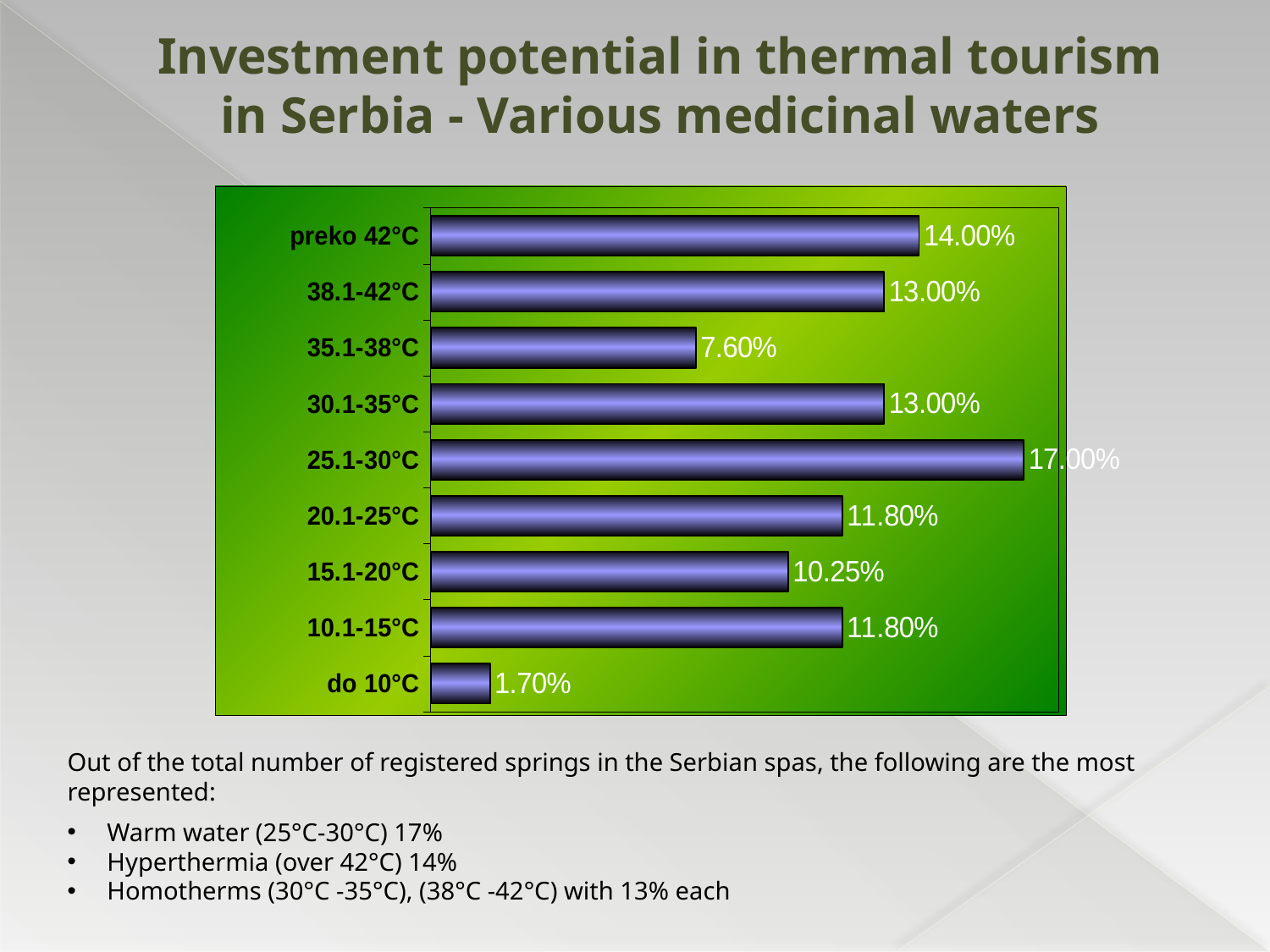
What is the value for the 15.1-20°C category? 10.25% What is the value for the do 10°C category? 1.70% What is the difference between the values for 20.1-25°C and 35.1-38°C? 4.20% Which category has the highest value? 25.1-30°C How many categories are shown in the chart? 9 What is the difference between the values for 25.1-30°C and preko 42°C? 3.00% What kind of chart is shown on the slide? Bar chart Which category has the lowest value? do 10°C Which two categories both have a value of 11.80%? 20.1-25°C and 10.1-15°C What is the value for the preko 42°C category? 14.00% Which is larger, the value for 38.1-42°C or the value for 35.1-38°C? 38.1-42°C What is the value for the 25.1-30°C category? 17.00%